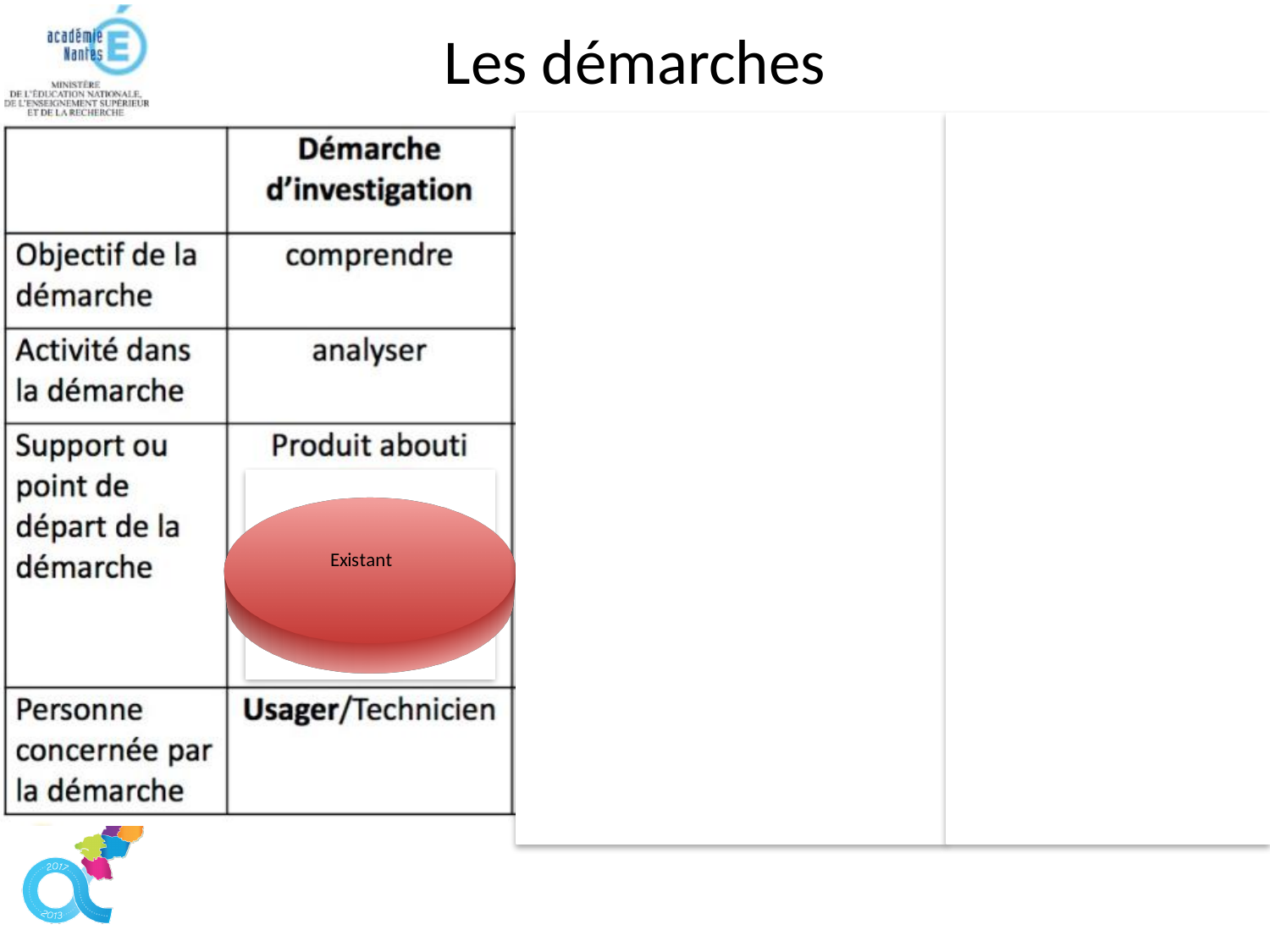
What colour is the slice of the pie chart? red What is the label on the single slice of the pie chart? Existant In which row of the table does the pie chart appear? Support ou point de départ de la démarche How many slices does the pie chart have? 1 What kind of chart is shown inside the table under "Produit abouti"? pie chart